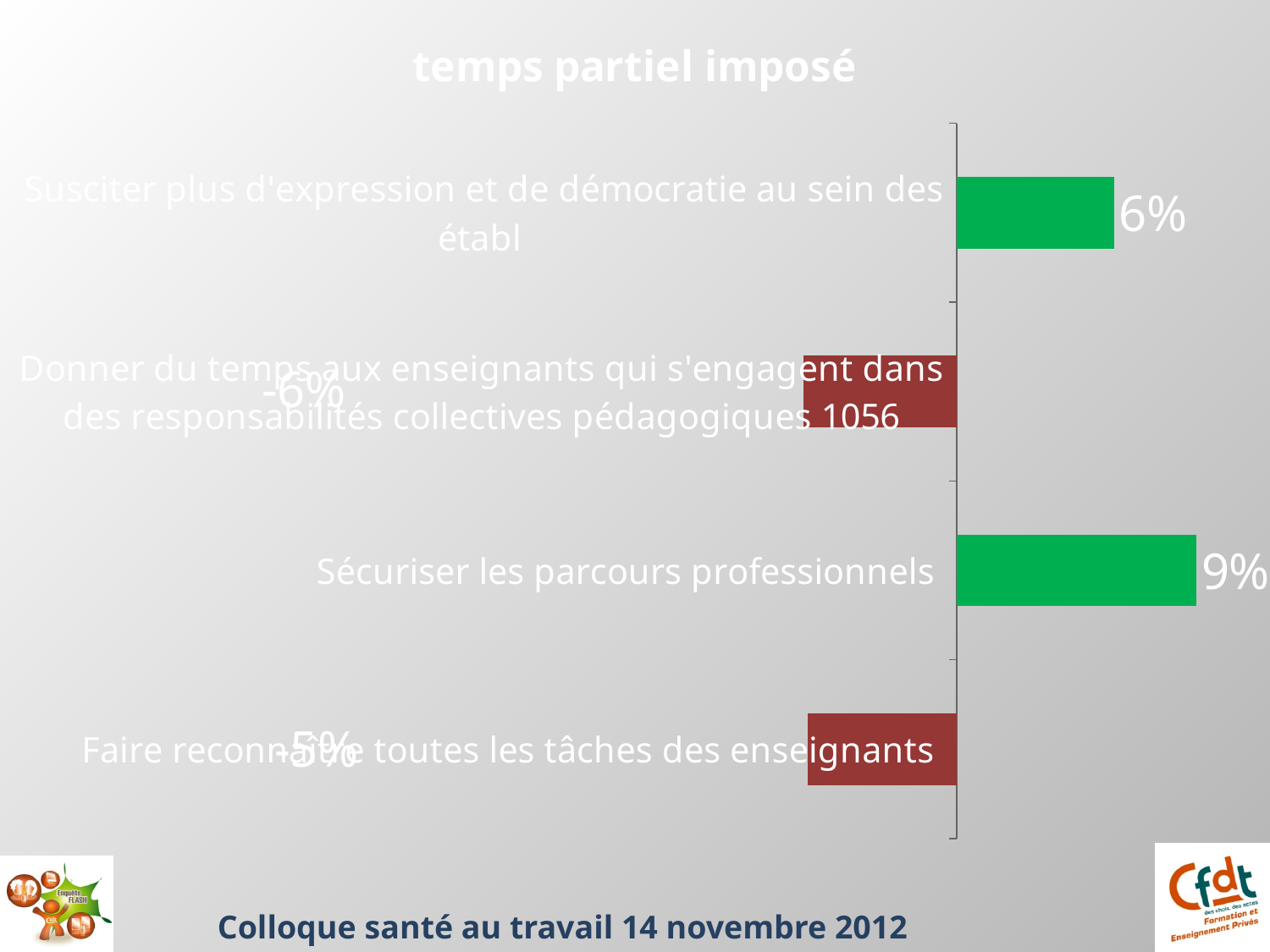
What is the title of the chart? temps partiel imposé What colour are the bars with negative values? red What is the value for "Faire reconnaître toutes les tâches des enseignants"? -5% Which is larger, the value for "Sécuriser les parcours professionnels" or the value for "Susciter plus d'expression et de démocratie au sein des établ"? Sécuriser les parcours professionnels What kind of chart is shown on the slide? bar chart What is the value for "Donner du temps aux enseignants qui s'engagent dans des responsabilités collectives pédagogiques 1056"? -6% What is the difference between the value for "Sécuriser les parcours professionnels" and the value for "Susciter plus d'expression et de démocratie au sein des établ"? 3% Which category has the highest value? Sécuriser les parcours professionnels What is the value for "Sécuriser les parcours professionnels"? 9% How many categories does the chart show? 4 Which category has the lowest value? Donner du temps aux enseignants qui s'engagent dans des responsabilités collectives pédagogiques 1056 What is the value for "Susciter plus d'expression et de démocratie au sein des établ"? 6%